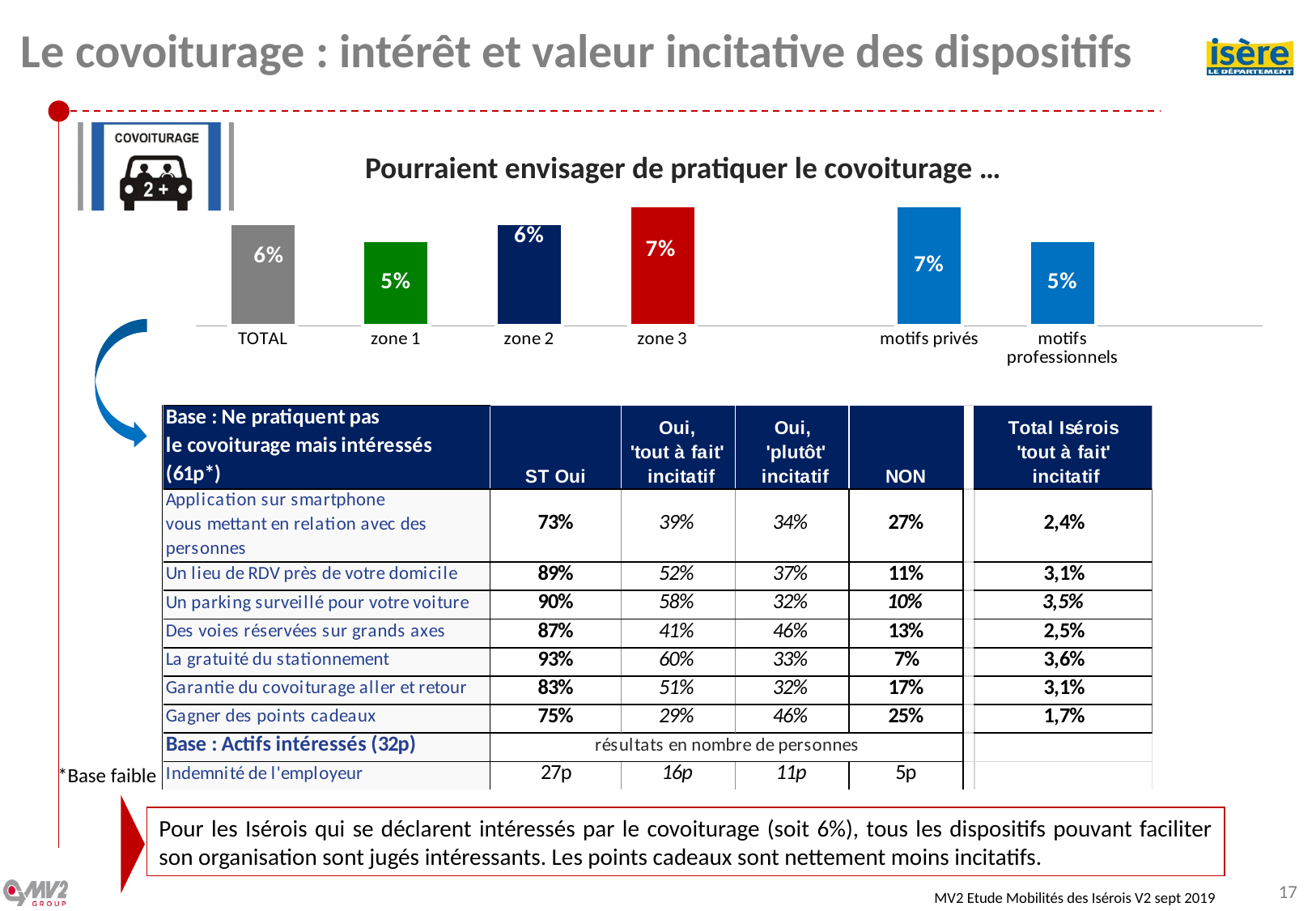
What value is shown for zone 2 in the bar chart? 6% What kind of chart is shown at the top of the slide? Bar chart What value is shown for 'motifs professionnels' in the bar chart? 5% What is the difference between the values for zone 3 and zone 1 in the bar chart? 2 percentage points Which is larger in the bar chart, the value for zone 3 or the value for zone 1? zone 3 What is the title of the bar chart on the slide? Pourraient envisager de pratiquer le covoiturage ... What value is shown for zone 3 in the bar chart? 7% What value is shown for TOTAL in the chart 'Pourraient envisager de pratiquer le covoiturage ...'? 6% What value is shown for 'motifs privés' in the bar chart? 7% Which is larger in the bar chart, the value for 'motifs privés' or the value for 'motifs professionnels'? motifs privés How many categories are shown in the bar chart? 6 What value is shown for zone 1 in the bar chart? 5%